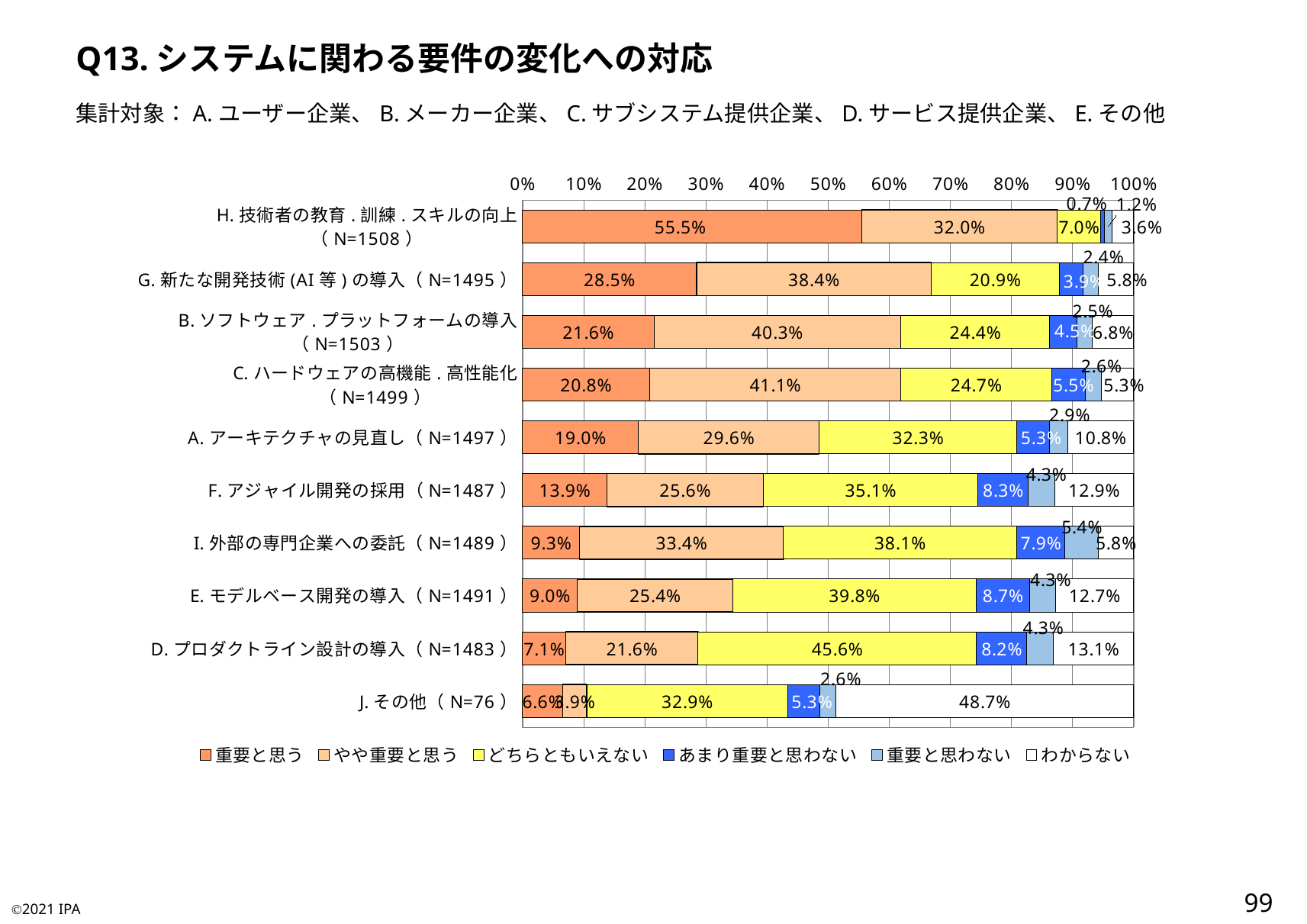
What is the 重要と思う value for H. 技術者の教育.訓練.スキルの向上? 55.5% What kind of chart is shown on the slide? Stacked bar chart What is the difference between the やや重要と思う values for C. ハードウェアの高機能.高性能化 and B. ソフトウェア.プラットフォームの導入? 0.8% What is the どちらともいえない value for D. プロダクトライン設計の導入? 45.6% Which category has the highest 重要と思う value? H. 技術者の教育.訓練.スキルの向上 How many categories (bars) are plotted in the chart? 10 What is the あまり重要と思わない value for F. アジャイル開発の採用? 8.3% What is the わからない value for J. その他? 48.7% Which is larger, the どちらともいえない value for E. モデルベース開発の導入 or for I. 外部の専門企業への委託? E. モデルベース開発の導入 What is the N value shown for G. 新たな開発技術(AI等)の導入? 1495 How many series does the legend list? 6 Which category has the lowest 重要と思う value? J. その他